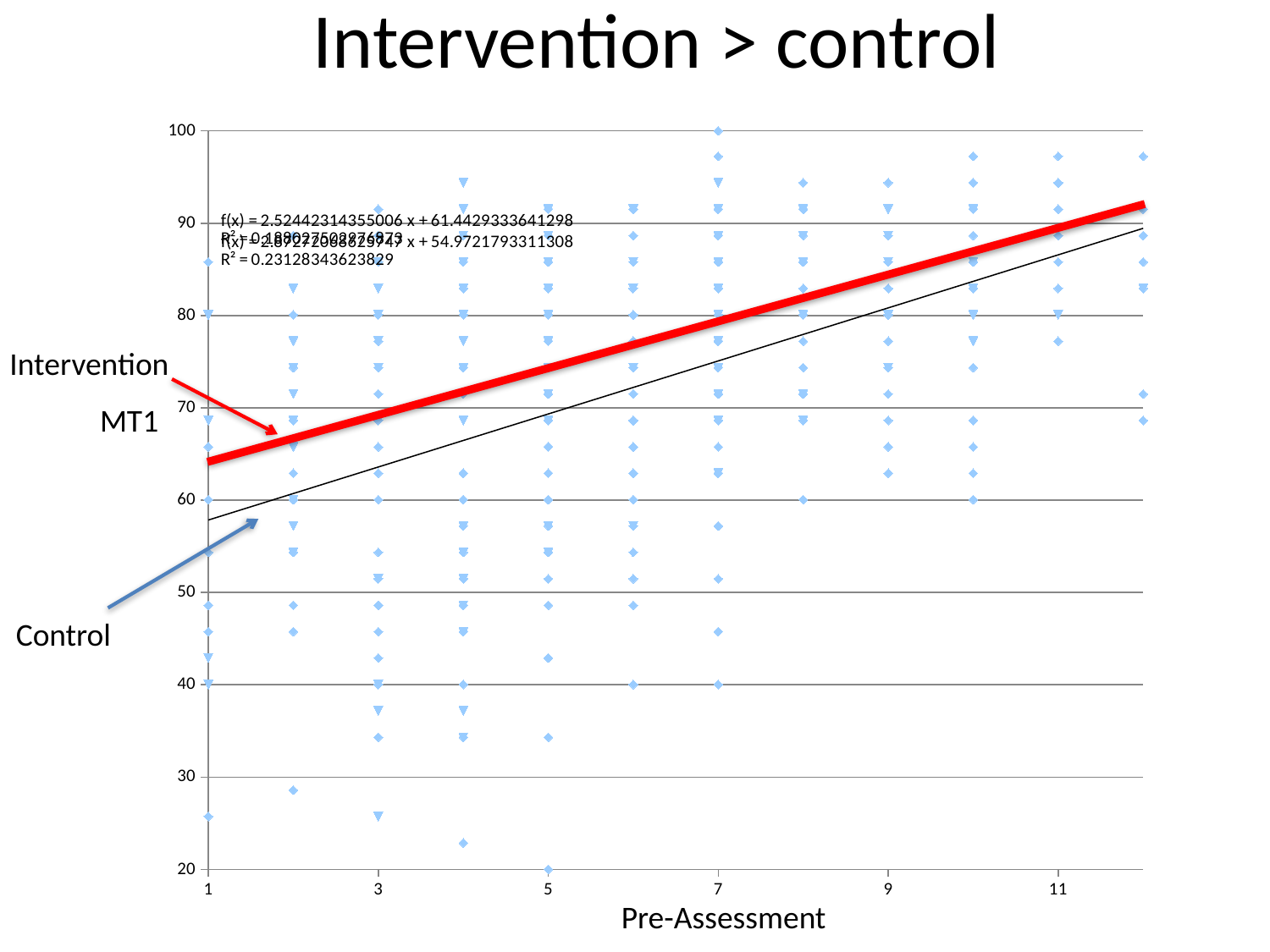
What is the R² value printed for the second trend line? 0.23128343623829 Do the trend lines rise or fall as Pre-Assessment increases? rise How many data series are annotated on the chart? 2 Is the Control trend line at Pre-Assessment 1 greater or less than 60? less What is the slope shown in the first trend line equation, f(x) = ? x + 61.4429333641298? 2.52442314355006 Is the Intervention trend line at Pre-Assessment 1 greater or less than 60? greater What is the title of the chart? Intervention > control What kind of chart is shown on the slide? scatter chart What is the lowest MT1 value plotted on the chart? 20 What is the highest MT1 value plotted on the chart? 100 Which trend line is higher across the chart, Intervention or Control? Intervention What is the label of the x axis? Pre-Assessment